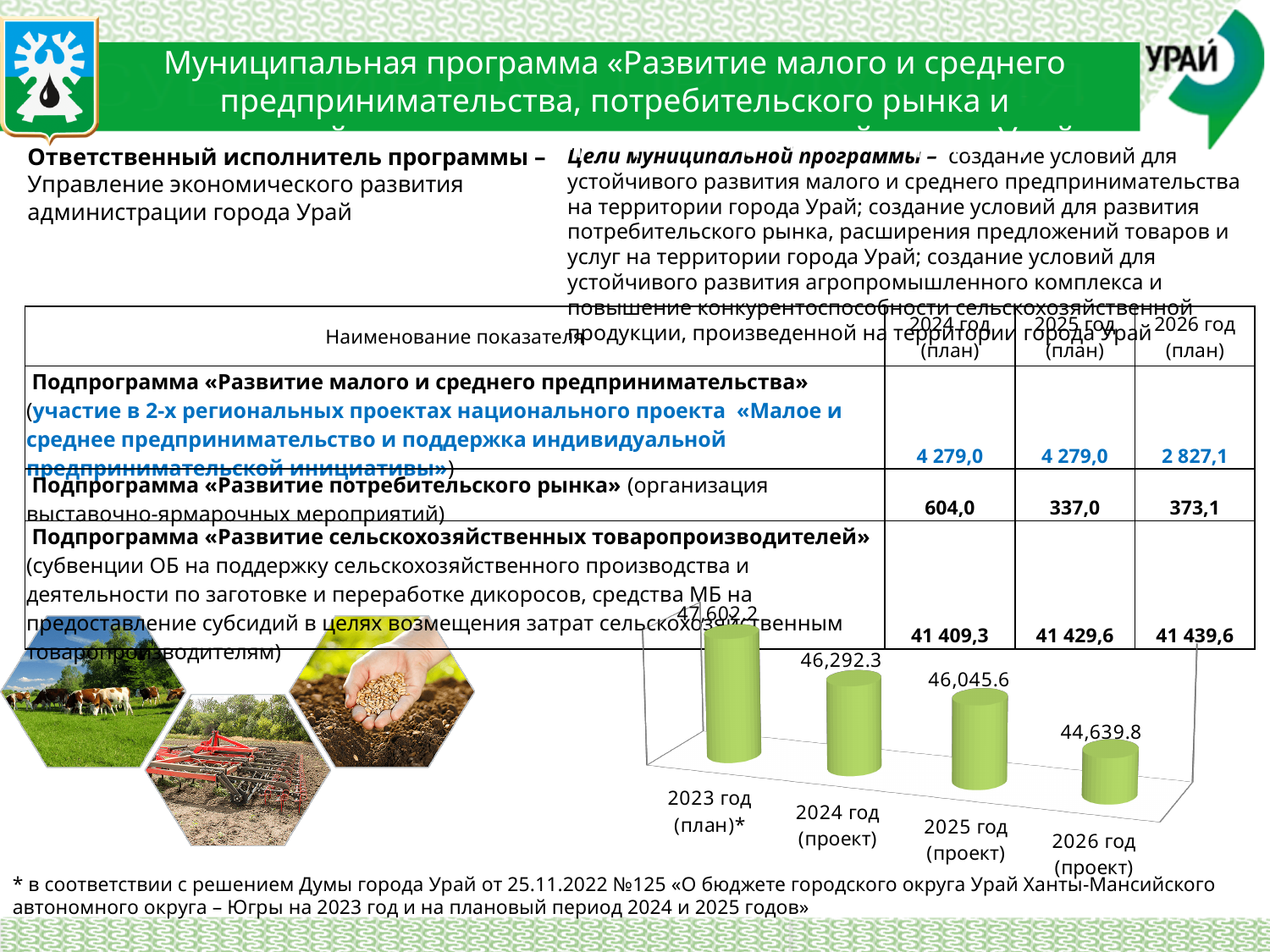
What is the value for 2026 год (проект) on the chart? 44,639.8 How many categories are shown on the chart? 4 Which is larger: the value for 2024 год (проект) or the value for 2026 год (проект)? 2024 год (проект) What is the difference between the values for 2024 год (проект) and 2025 год (проект)? 246.7 Which category has the lowest value on the chart? 2026 год (проект) What kind of chart is shown on the slide? Bar chart What is the difference between the values for 2025 год (проект) and 2026 год (проект)? 1,405.8 Do the values rise or fall from 2023 год (план)* to 2026 год (проект)? Fall Which category has the highest value on the chart? 2023 год (план)* What is the value for 2024 год (проект) on the chart? 46,292.3 What is the value for 2023 год (план)* on the chart? 47,602.2 What is the value for 2025 год (проект) on the chart? 46,045.6